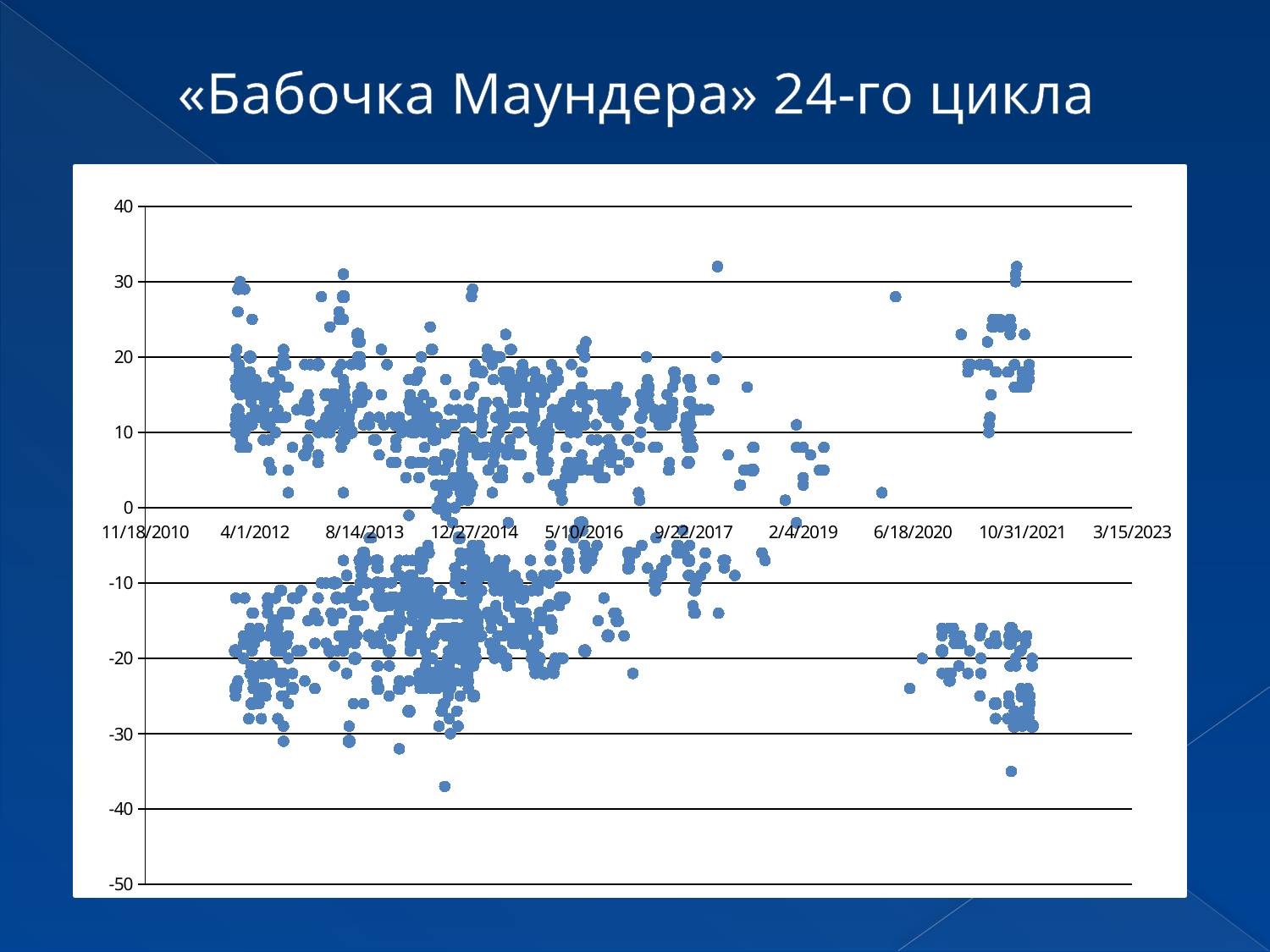
Is the lowest plotted point on the chart greater or less than -30? less Is the lowest plotted point on the chart greater or less than -40? greater What is the title of the chart? «Бабочка Маундера» 24-го цикла Is the highest plotted point on the chart greater or less than 30? greater What is the highest value shown on the vertical axis? 40 What kind of chart is shown on the slide? scatter chart